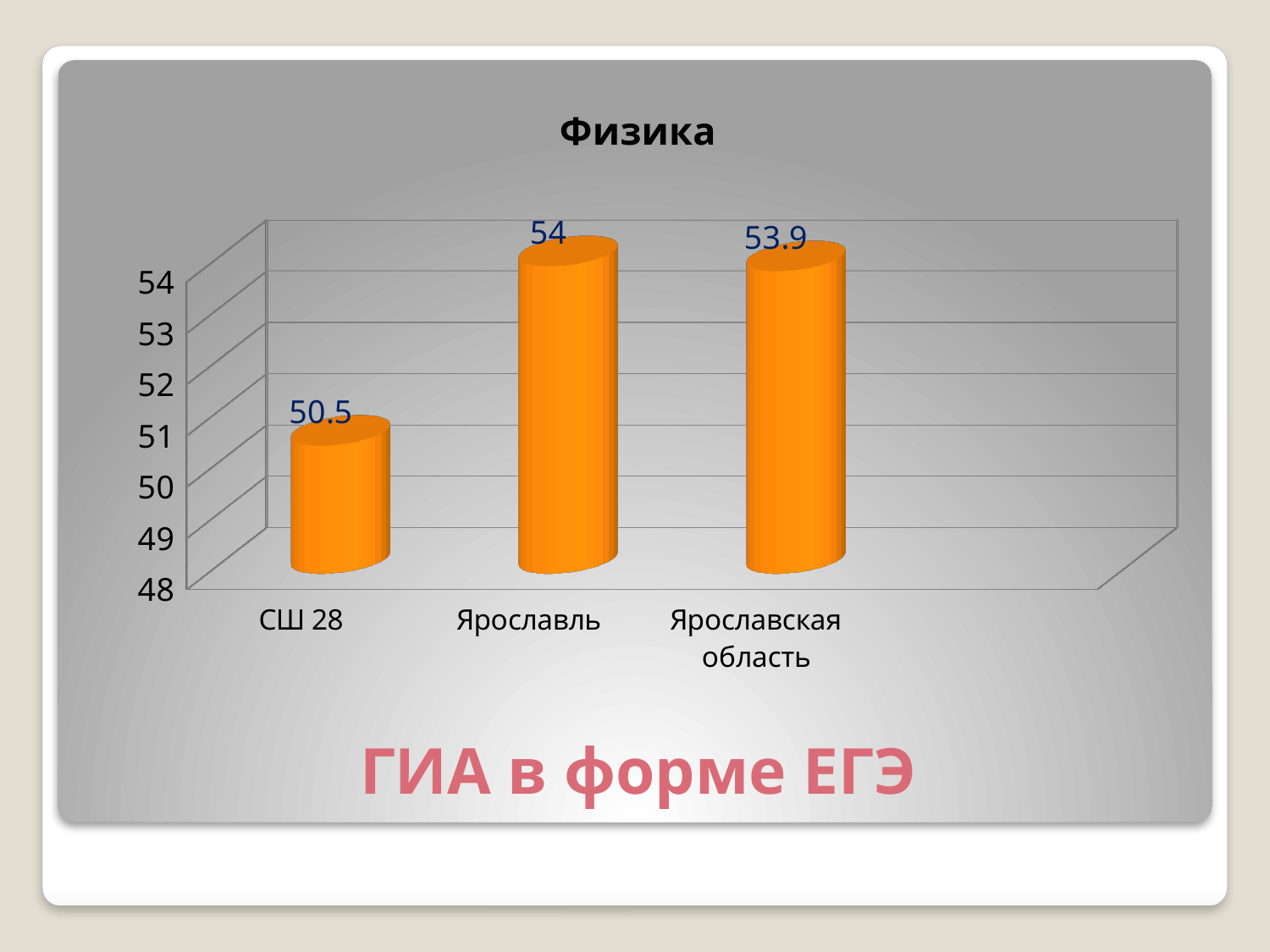
Which category has the lowest value? СШ 28 Which is larger, the value for СШ 28 or the value for Ярославская область? Ярославская область What kind of chart is shown on the slide? bar chart What is the value for СШ 28? 50.5 What is the value for Ярославль? 54 What is the difference between the values for Ярославль and СШ 28? 3.5 How many categories are shown in the chart? 3 Which category has the highest value? Ярославль What is the title of the chart? Физика What is the value for Ярославская область? 53.9 What is the difference between the values for Ярославская область and СШ 28? 3.4 Is the value for СШ 28 greater or less than 52? less